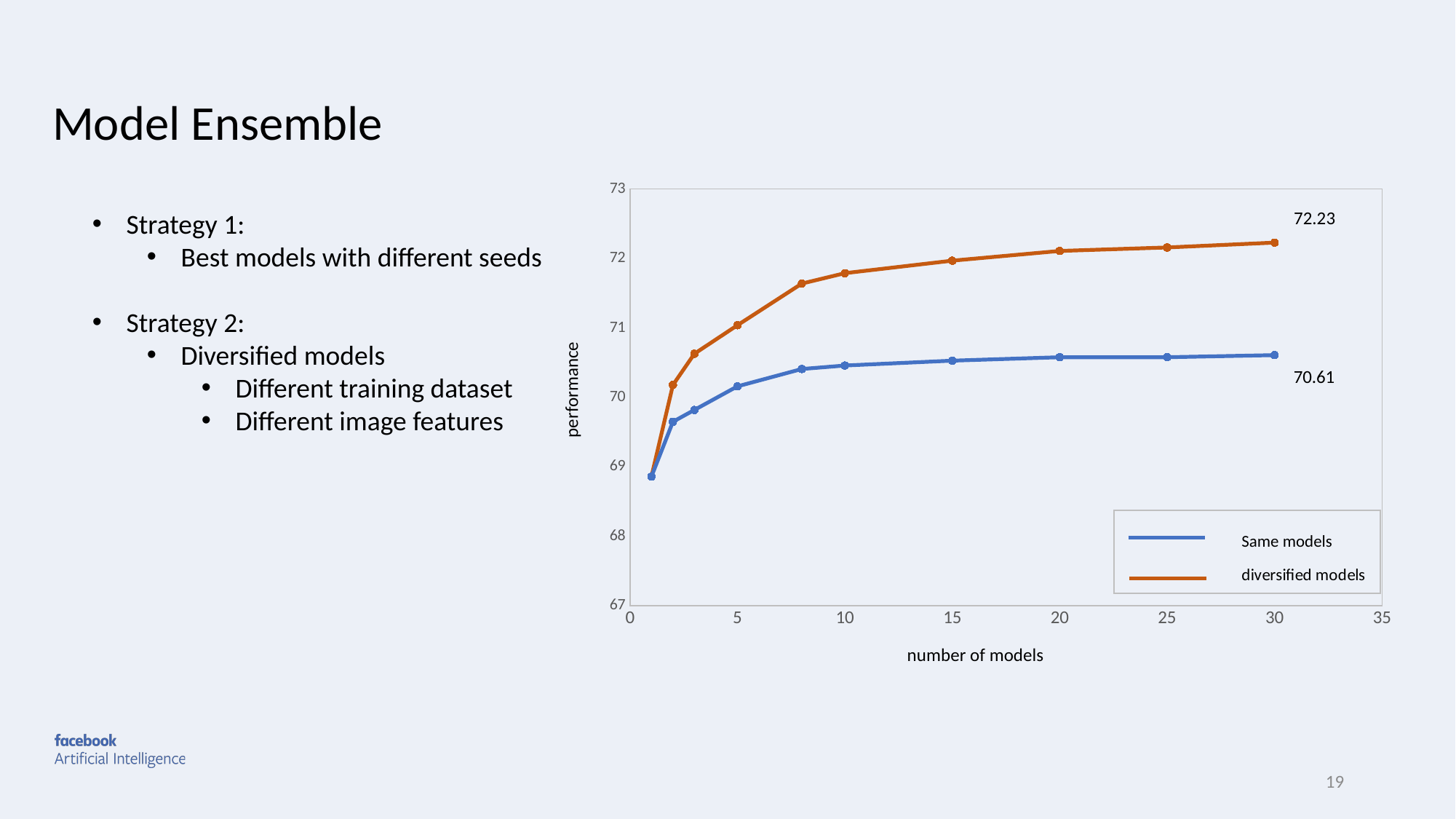
What kind of chart is shown on the slide? line chart What is the difference in performance between the diversified models and the Same models at 30 models? 1.62 Do the performance values rise or fall as the number of models increases? rise Is the performance of the diversified models at 5 models greater or less than 70? greater What is the title of the y axis? performance How many series does the legend list? 2 At 30 models, which series has the higher performance, Same models or diversified models? diversified models What is the performance of the Same models at 30 models? 70.61 What is the title of the x axis? number of models How many data points are plotted for the diversified models series? 10 Is the performance of the Same models at 10 models greater or less than 71? less What is the performance of the diversified models at 30 models? 72.23